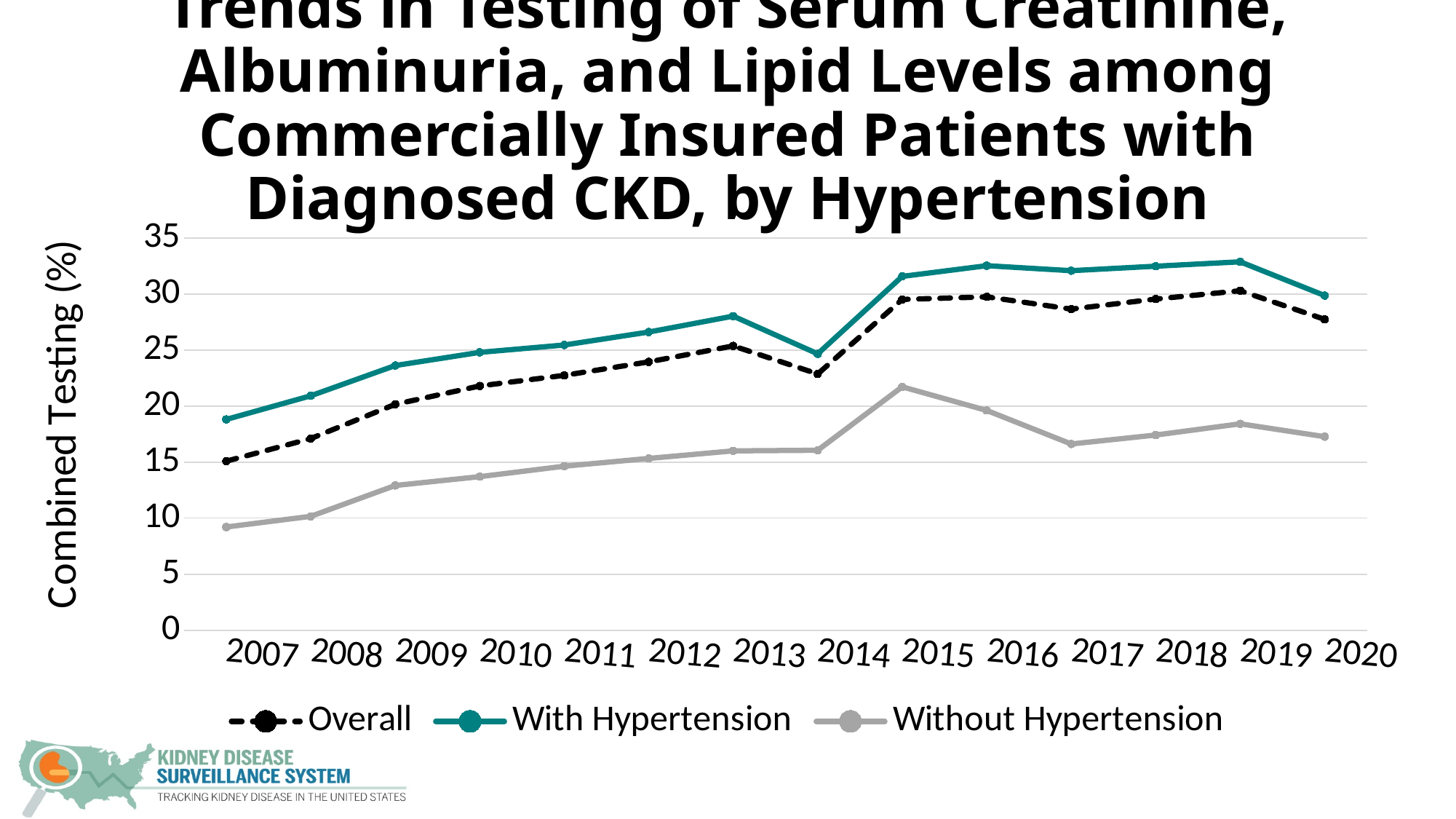
Is the value for Overall in 2020 greater or less than 25? greater Is the value for With Hypertension in 2007 greater or less than 20? less In which year is the Overall series at its lowest? 2007 How many years are plotted along the x axis? 14 What kind of chart is shown on the slide? line chart How many series does the legend list? 3 Is the value for With Hypertension in 2019 greater or less than 30? greater In which year is the Without Hypertension series at its highest? 2015 Does the Without Hypertension series rise or fall from 2007 to 2015? rise In 2015, which is larger: the value for With Hypertension or the value for Without Hypertension? With Hypertension